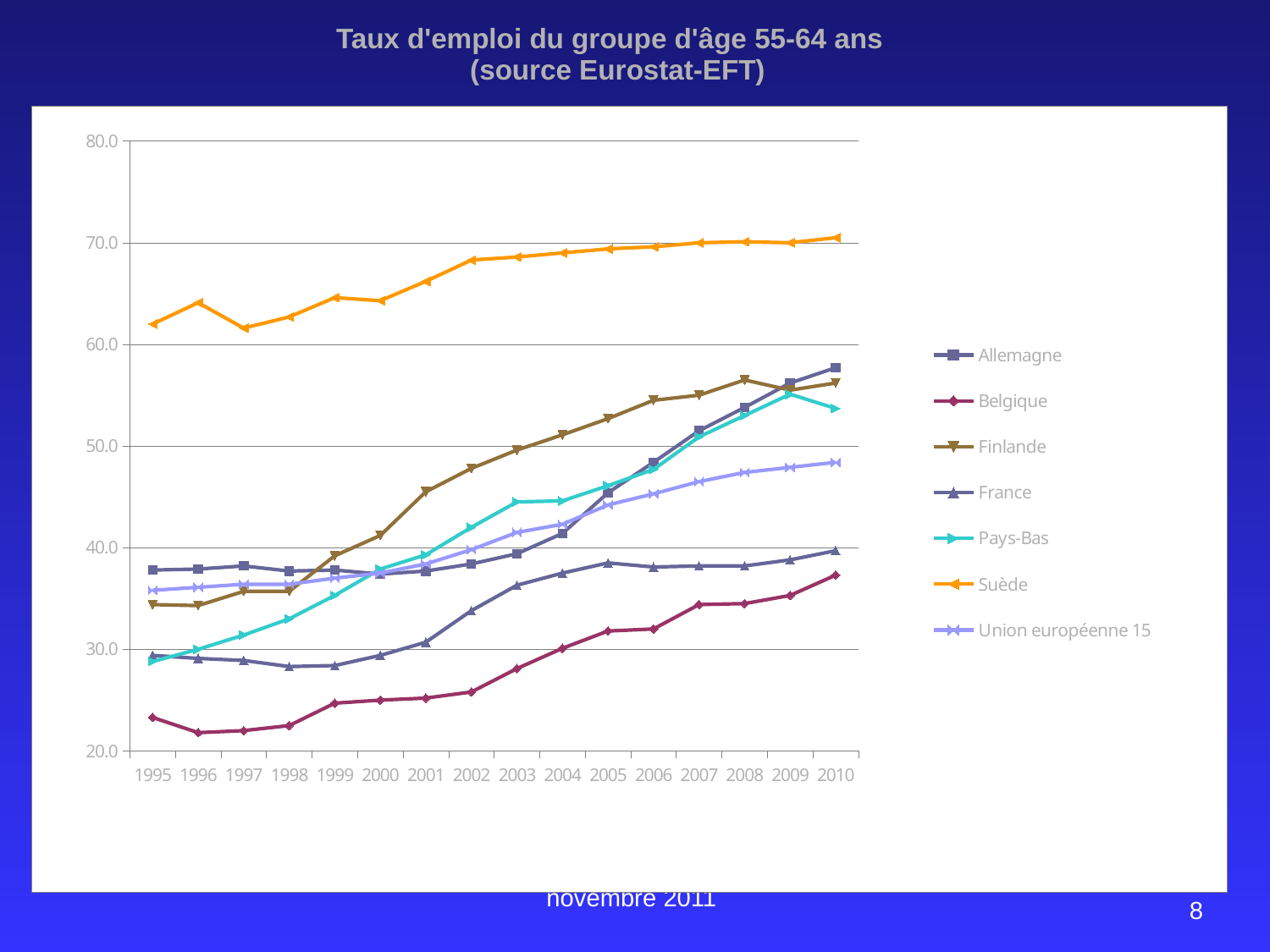
Does the value for Belgique generally rise or fall from 1995 to 2010? rise Is the value for Finlande in 2010 greater or less than 50.0? greater What kind of chart is shown on the slide? line chart Is the value for Belgique in 1996 greater or less than 30.0? less Which series has the highest value in 2010? Suède Which series has the lowest value in 2010? Belgique How many years are shown along the x axis? 16 How many series does the legend list? 7 Is the value for France in 2005 greater or less than 40.0? less In 2010, which is larger: the value for Allemagne or the value for France? Allemagne Which series is drawn in orange? Suède